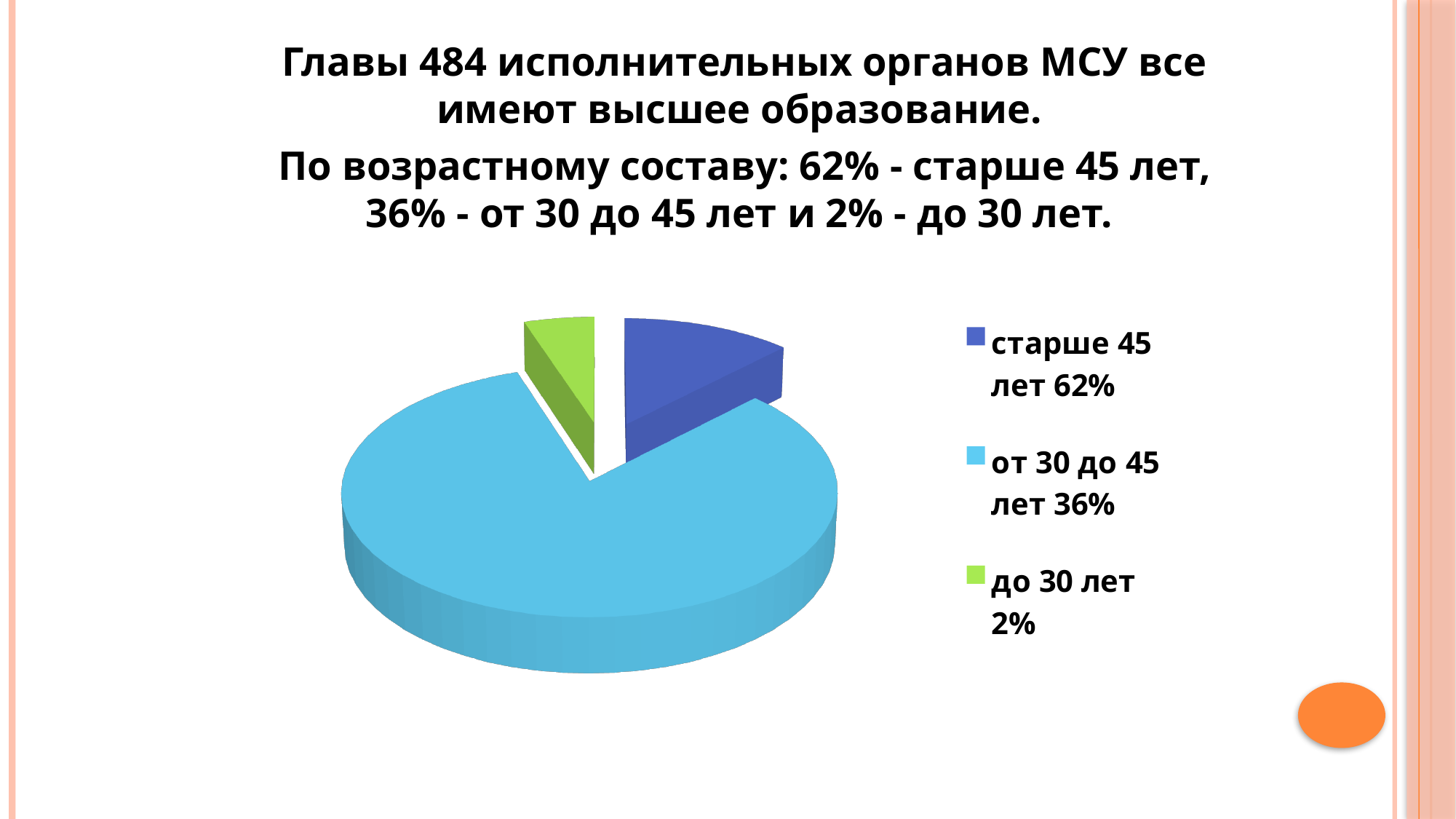
What is the difference in percentage points between the shares labelled for 'старше 45 лет' and 'от 30 до 45 лет'? 26 What share of the pie is labelled for the category 'старше 45 лет'? 62% What colour is the legend marker for the category 'до 30 лет'? green According to the legend, which share is larger: 'от 30 до 45 лет' or 'до 30 лет'? от 30 до 45 лет How many categories does the pie chart's legend list? 3 How many heads of executive bodies of local self-government are mentioned in the slide title? 484 What kind of chart is shown on the slide? pie chart According to the legend, which category has the largest share? старше 45 лет What is the difference in percentage points between the shares labelled for 'от 30 до 45 лет' and 'до 30 лет'? 34 What share of the pie is labelled for the category 'до 30 лет'? 2% According to the legend, which category has the smallest share? до 30 лет What share of the pie is labelled for the category 'от 30 до 45 лет'? 36%